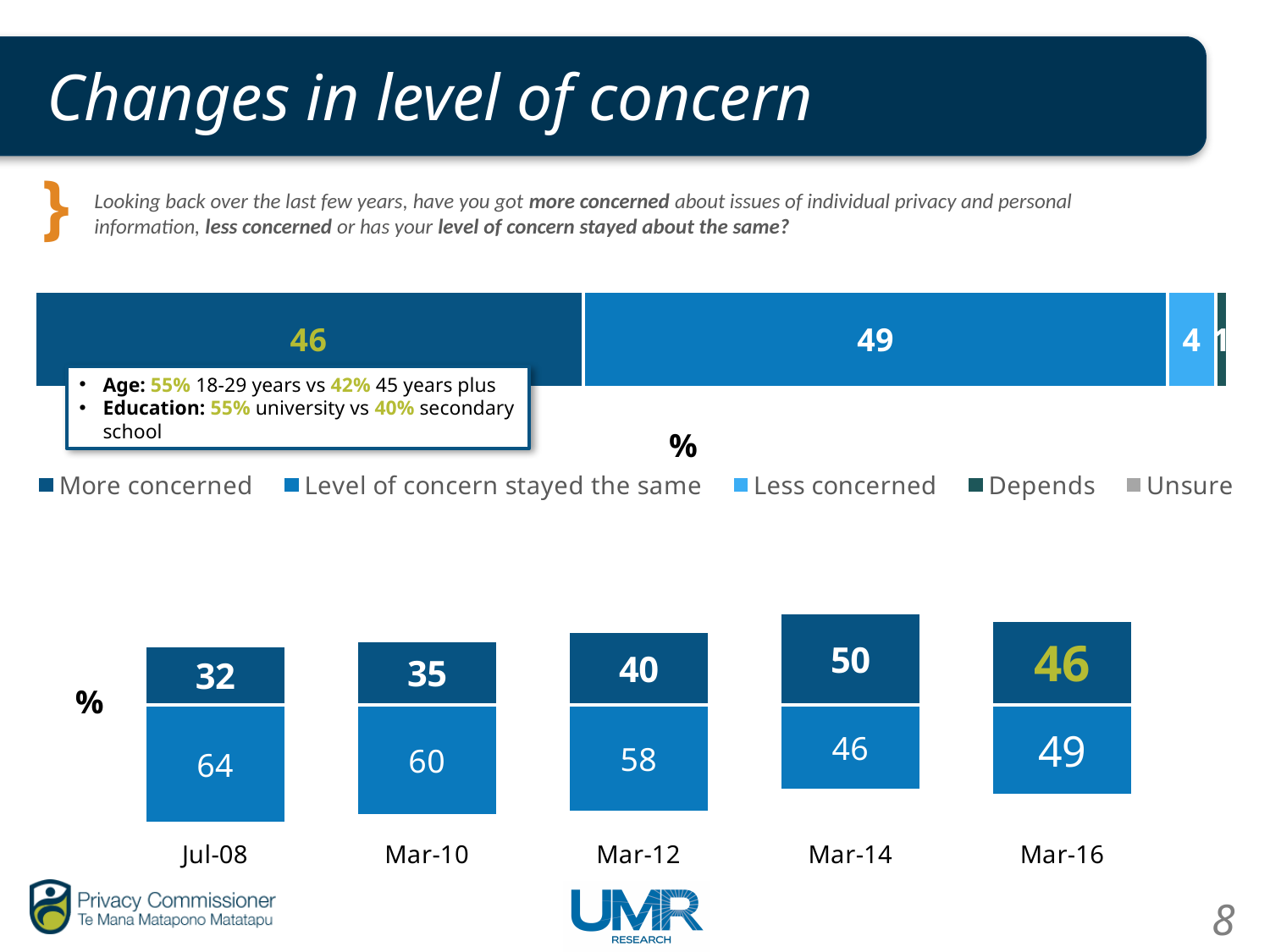
In the top chart, what value is shown for 'Less concerned'? 4 In the bottom chart, what is the value of the dark blue top segment for Mar-14? 50 How many series does the legend of the top chart list? 5 How many time points are shown on the x axis of the bottom chart? 5 What type of chart is the top chart? Stacked bar chart In the bottom chart, which time point has the highest value for the dark blue top segment? Mar-14 In the bottom chart, which time point has the lowest value for the lighter blue bottom segment? Mar-14 In the top chart, what percentage of respondents said they were more concerned? 46 In the top chart, which is larger: 'More concerned' or 'Level of concern stayed the same'? Level of concern stayed the same In the bottom chart, what is the value of the lighter blue bottom segment for Jul-08? 64 In the top chart, what value is shown for 'Level of concern stayed the same'? 49 In the bottom chart, what is the difference between the dark blue top segment values for Mar-14 and Jul-08? 18